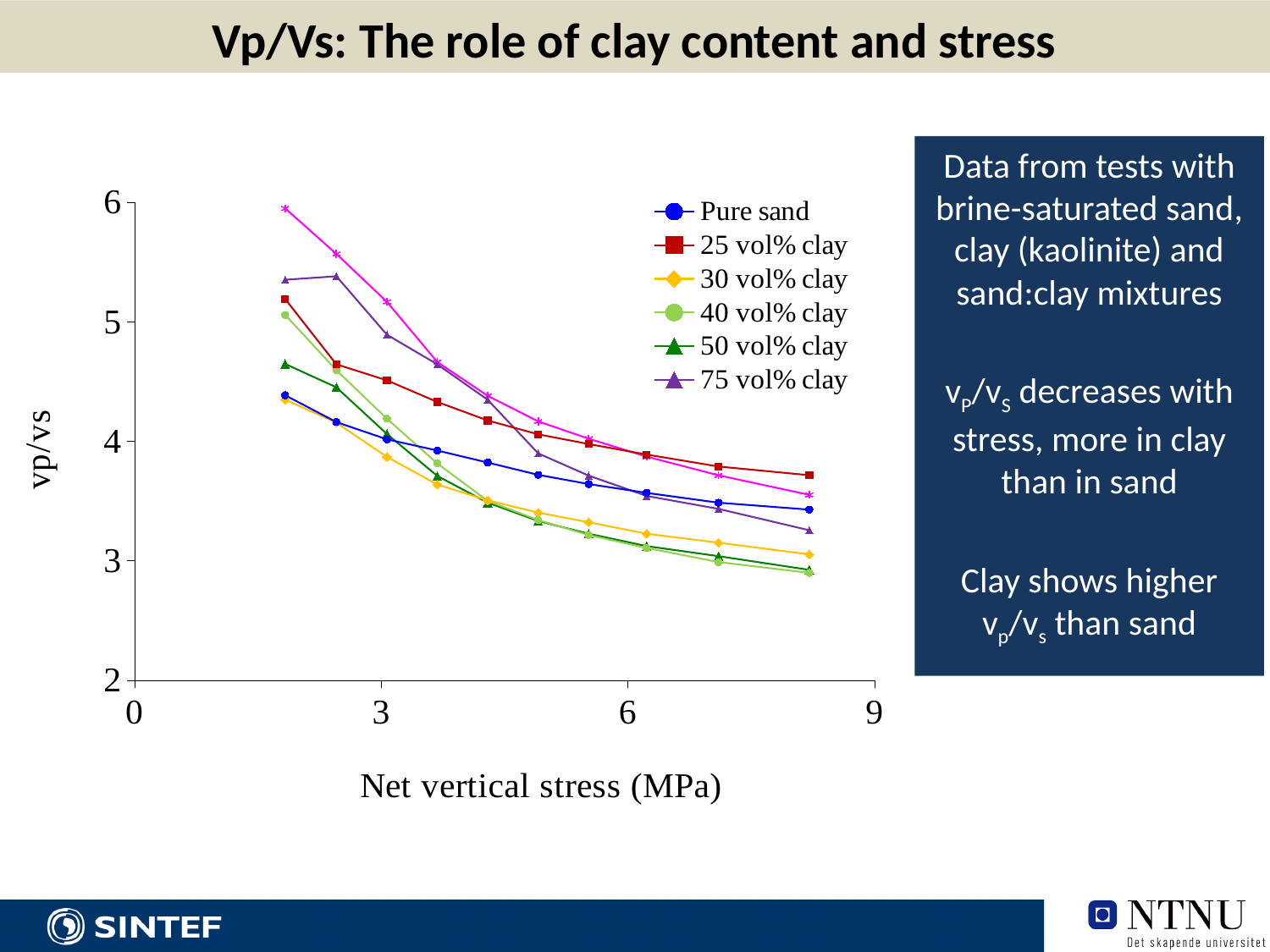
How many series does the chart legend list? 6 Is the vp/vs value for 75 vol% clay at the lowest plotted stress greater or less than 5? greater What is the title of the chart's x axis? Net vertical stress (MPa) Is the vp/vs value for Pure sand at the highest plotted stress greater or less than 3? greater Is the vp/vs value for 40 vol% clay at the highest plotted stress greater or less than 3? less Do the vp/vs values for the 25 vol% clay series rise or fall as net vertical stress increases? fall What is the label on the chart's y axis? vp/vs What kind of chart is shown on the slide? line chart Do the vp/vs values for the Pure sand series rise or fall as net vertical stress increases? fall At the lowest plotted stress, which has the larger vp/vs value: 40 vol% clay or Pure sand? 40 vol% clay At the highest plotted stress, which has the larger vp/vs value: 25 vol% clay or Pure sand? 25 vol% clay